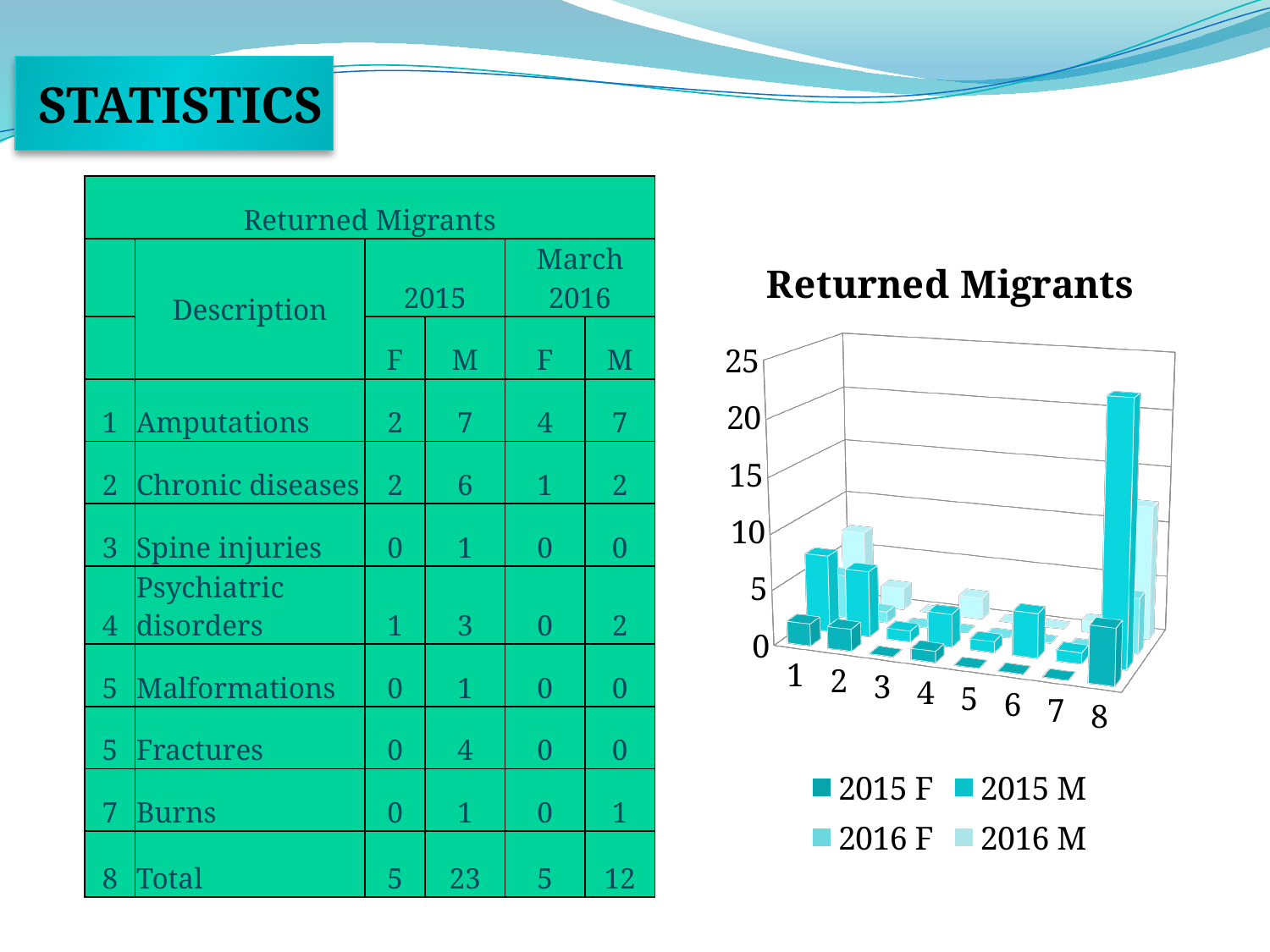
Is the 2015 M value for category 1 greater or less than 5? greater What kind of chart is shown on the slide? bar chart Is the 2015 F value for category 3 greater or less than 5? less Which category has the tallest bar in the chart? 8 How many categories are shown along the x axis of the chart? 8 Is the 2015 M value for category 8 greater or less than 20? greater What is the highest value shown on the chart's vertical axis? 25 How many series does the chart legend list? 4 For category 8, which is larger: the 2015 M bar or the 2016 M bar? 2015 M Which series has the tallest bar for category 8? 2015 M What is the title of the chart? Returned Migrants